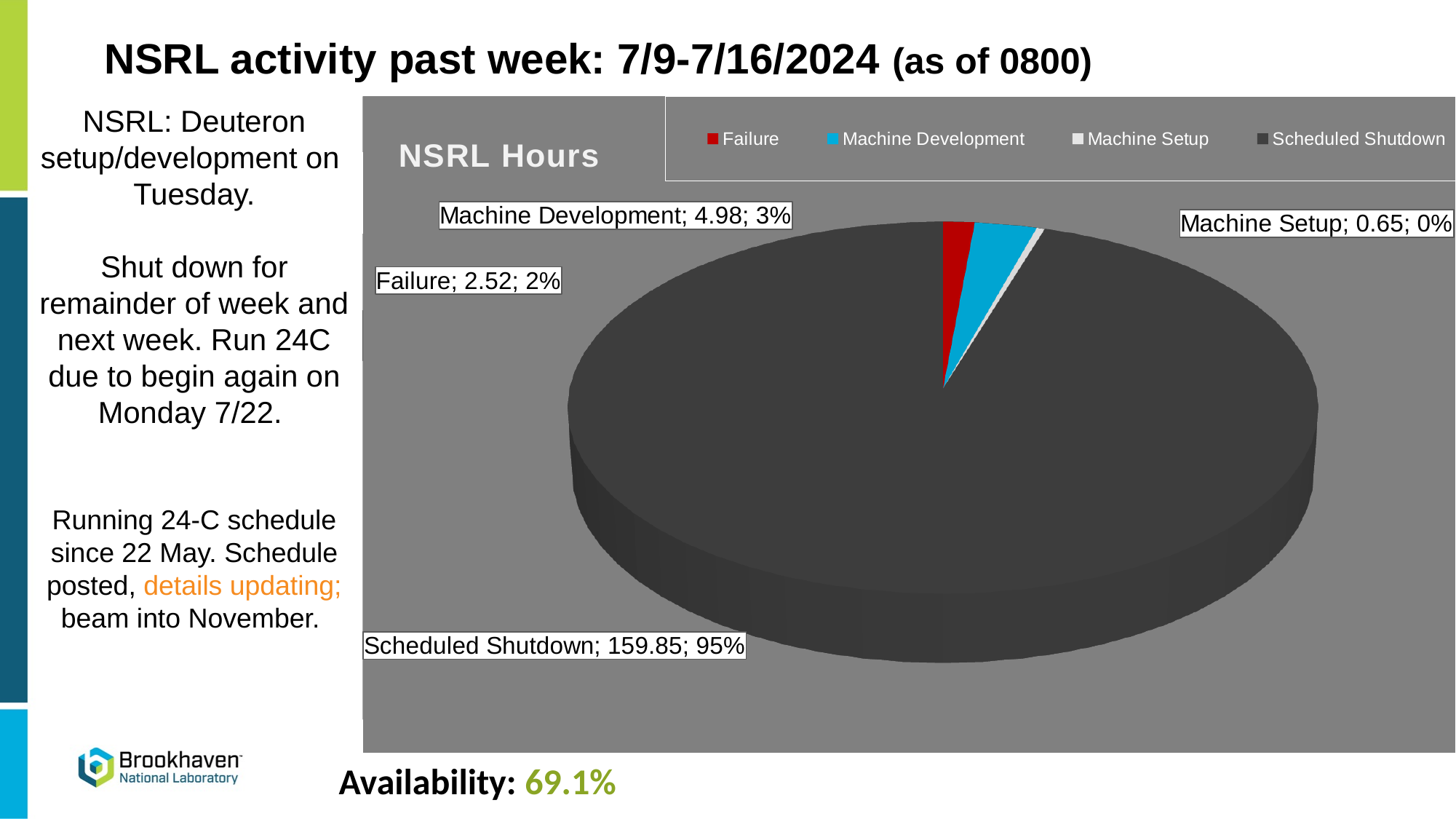
What type of chart is shown on the slide? Pie chart How many hours are attributed to Machine Setup in the NSRL Hours chart? 0.65 Which category has the smallest slice in the NSRL Hours chart? Machine Setup What is the title of the chart? NSRL Hours How many categories does the legend of the NSRL Hours chart list? 4 How many hours are attributed to Failure in the NSRL Hours chart? 2.52 How many hours are attributed to Machine Development in the NSRL Hours chart? 4.98 What percentage share of the NSRL Hours pie is Scheduled Shutdown? 95% How many hours are attributed to Scheduled Shutdown in the NSRL Hours chart? 159.85 Which category has the largest slice in the NSRL Hours chart? Scheduled Shutdown What is the difference in hours between Machine Development and Failure in the NSRL Hours chart? 2.46 Which has more hours in the NSRL Hours chart, Failure or Machine Development? Machine Development